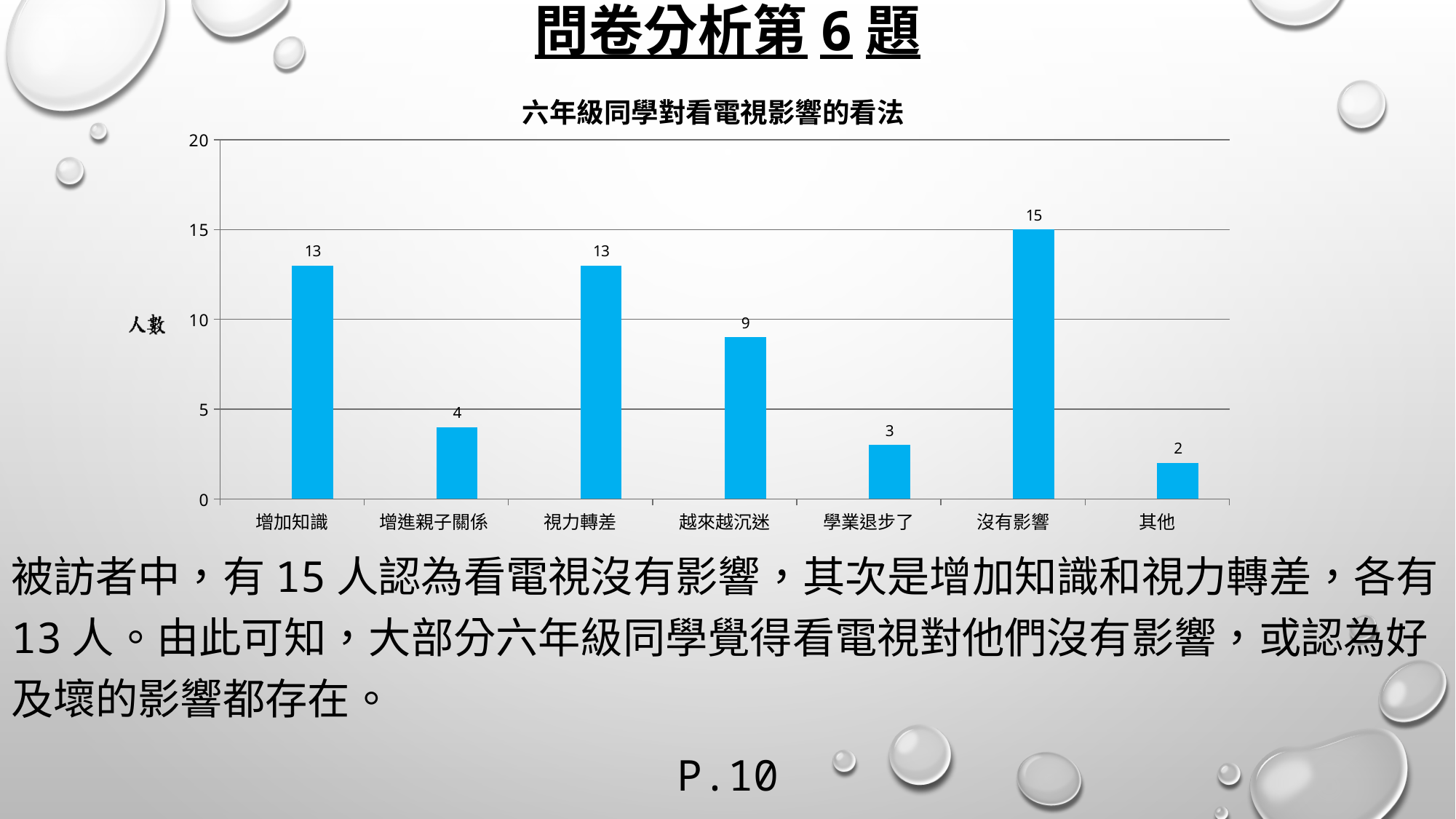
How many categories are shown on the x axis? 7 What is the value for 越來越沉迷? 9 Which is larger, the value for 越來越沉迷 or the value for 學業退步了? 越來越沉迷 Which category has the highest value? 沒有影響 What is the title of the chart? 六年級同學對看電視影響的看法 What is the value for 增進親子關係? 4 What is the label of the y axis? 人數 What is the value for 沒有影響? 15 Is the value for 增加知識 greater or less than 10? greater What is the difference between the values for 沒有影響 and 視力轉差? 2 Which category has the lowest value? 其他 What kind of chart is shown? bar chart